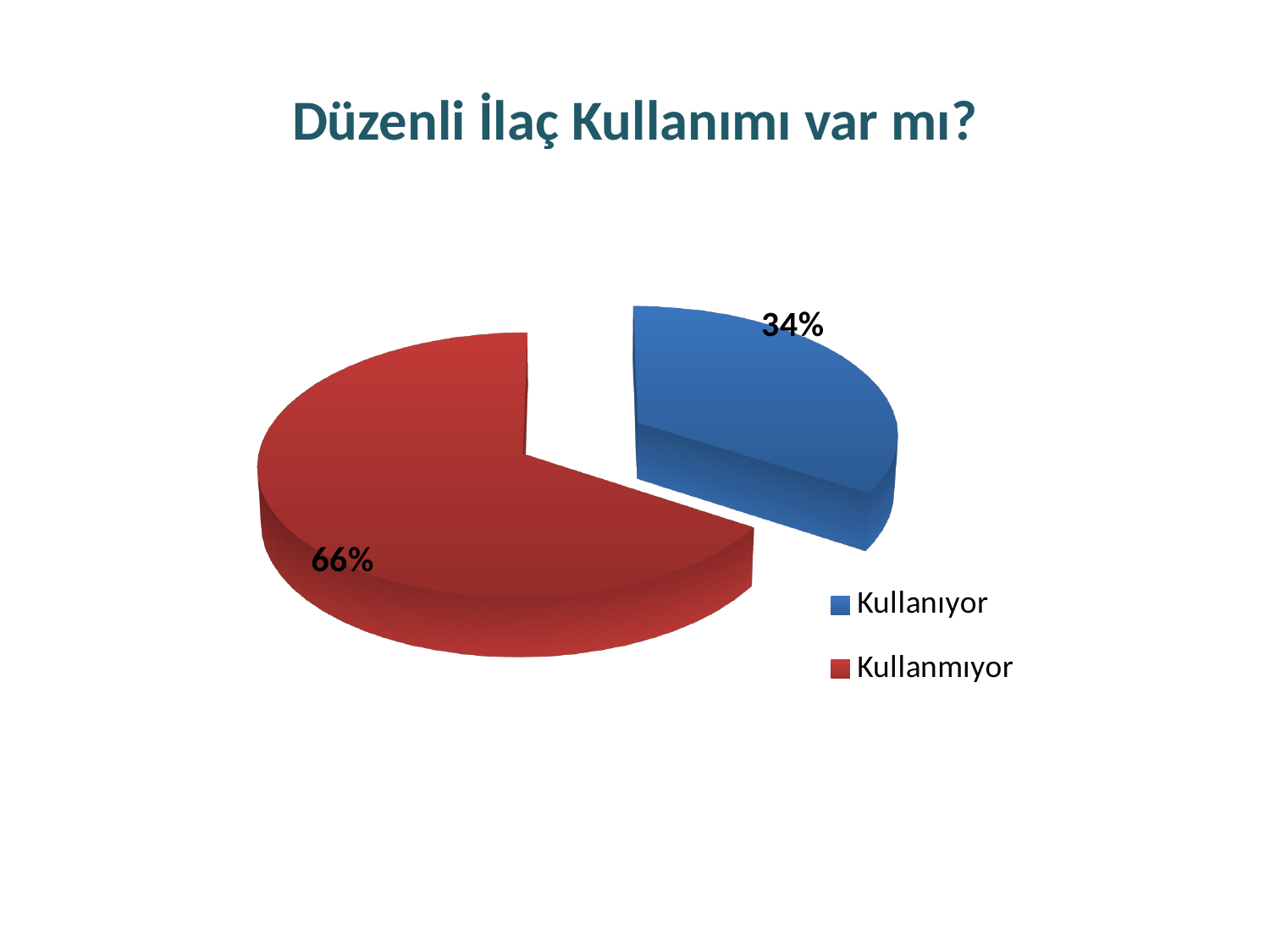
What share of the pie does Kullanmıyor represent? 66% What is the difference in percentage points between Kullanmıyor and Kullanıyor? 32 How many entries does the legend list? 2 Which is larger, the Kullanıyor slice or the Kullanmıyor slice? Kullanmıyor What is the title of the slide? Düzenli İlaç Kullanımı var mı? Which category has the smallest slice of the pie? Kullanıyor How many categories are shown in the pie chart? 2 What colour is the Kullanmıyor slice? Red What kind of chart is shown on the slide? Pie chart What share of the pie does Kullanıyor represent? 34% Which category has the largest slice of the pie? Kullanmıyor